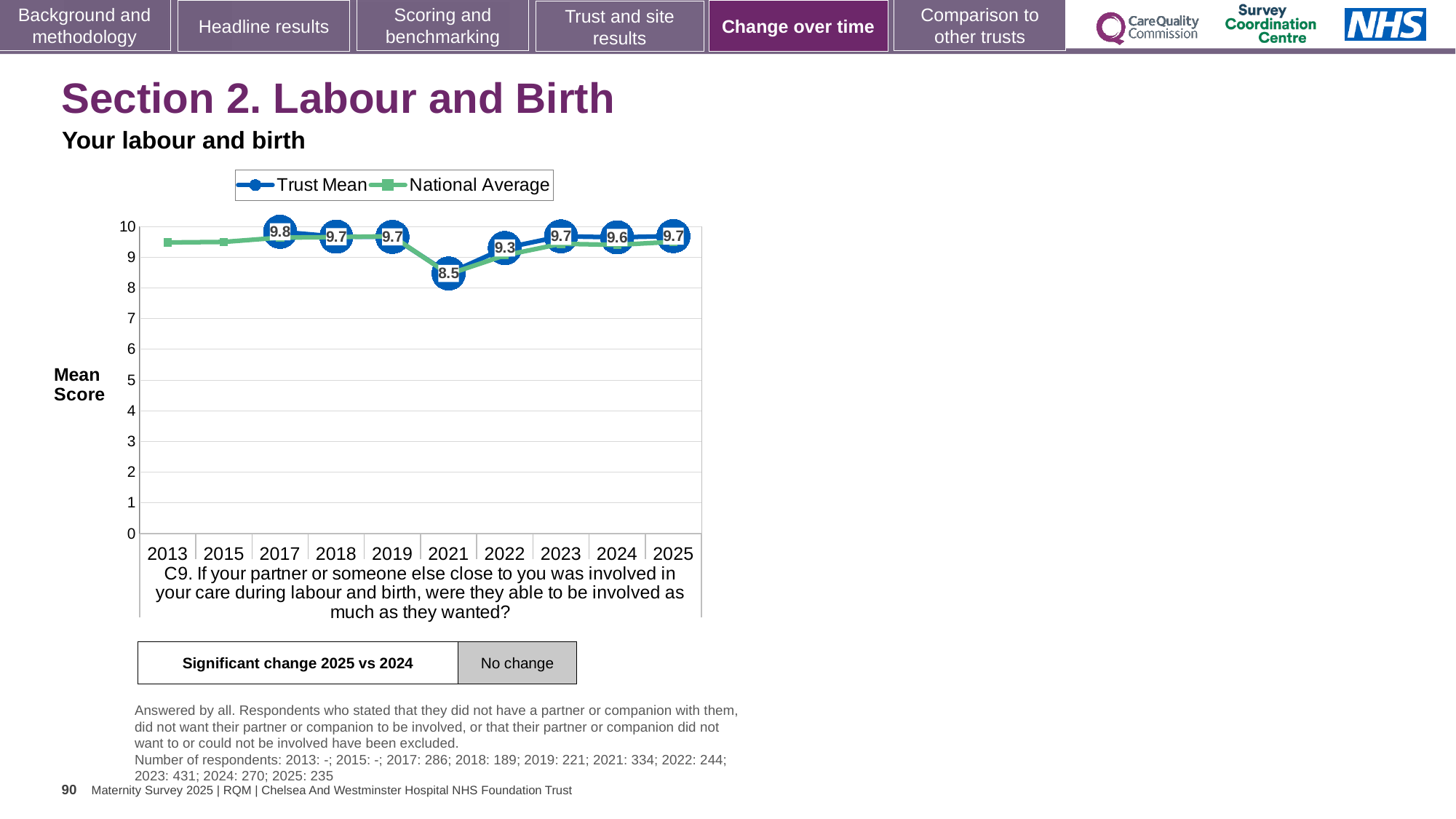
Which is larger, the Trust Mean for 2024 or for 2025? 2025 What is the Trust Mean value for 2021? 8.5 What is the difference between the Trust Mean in 2022 and in 2021? 0.8 Is the National Average value for 2013 greater or less than 9? greater How many years are shown on the x axis? 10 How many series does the legend list? 2 Does the Trust Mean rise or fall from 2019 to 2021? Fall What is the Trust Mean value for 2017? 9.8 In which year is the Trust Mean lowest? 2021 In which year is the Trust Mean highest? 2017 What kind of chart is shown on the slide? Line chart What is the Trust Mean value for 2025? 9.7